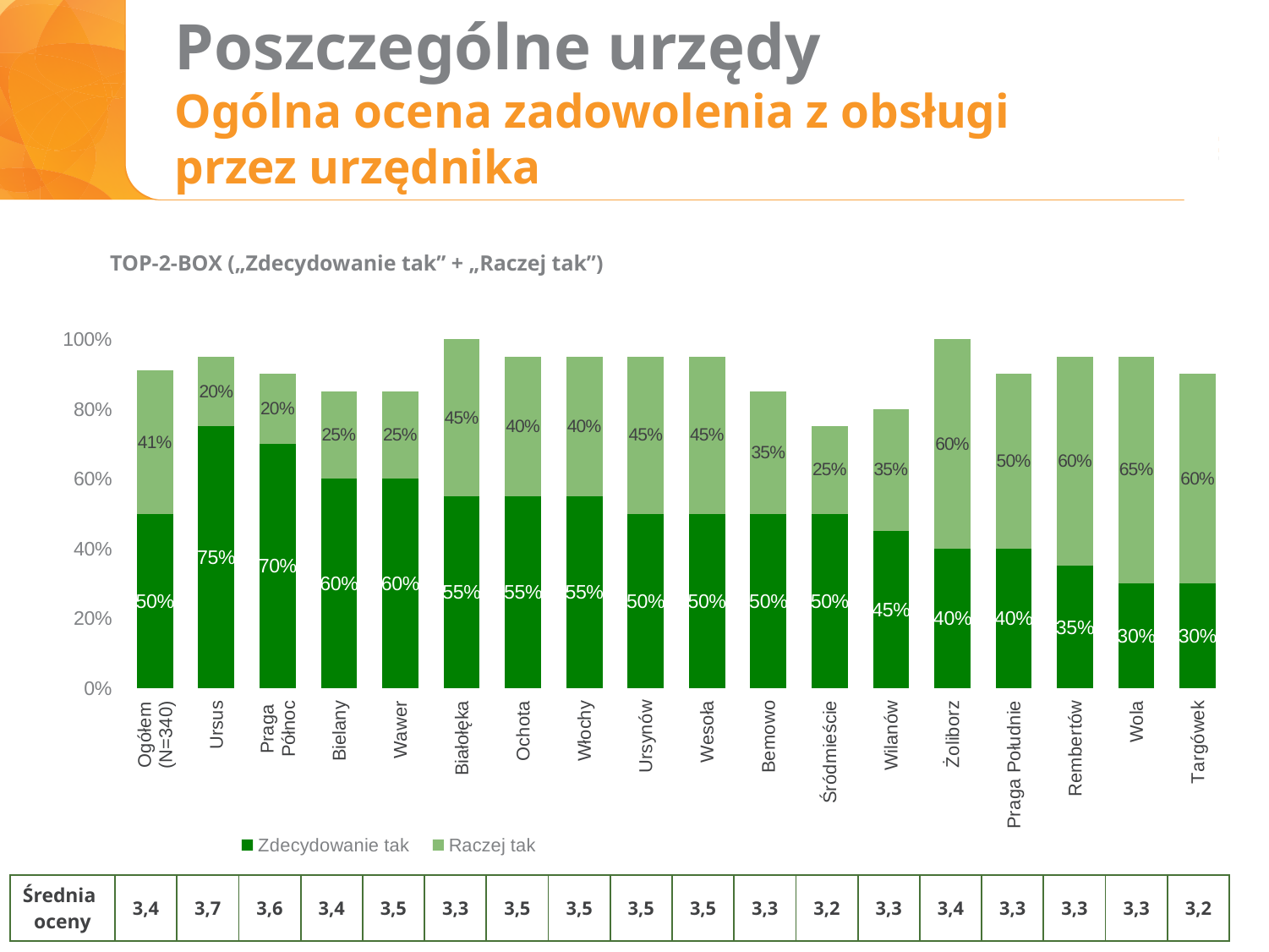
What is the "Zdecydowanie tak" value for Ursus? 75% Which category has the highest "Raczej tak" value? Wola What is the total of the stacked bar for Ogółem (N=340)? 91% How many series does the legend list? 2 Which category has the lowest total stacked bar (TOP-2-BOX)? Śródmieście Which category has the highest "Zdecydowanie tak" value? Ursus What is the difference between the "Zdecydowanie tak" values for Ursus and Targówek? 45% Which is larger, the "Zdecydowanie tak" value for Bielany or for Wilanów? Bielany How many categories are shown on the x axis of the chart? 18 What is the "Zdecydowanie tak" value for Ogółem (N=340)? 50% What is the total of the stacked bar for Śródmieście? 75% What is the "Raczej tak" value for Wola? 65%